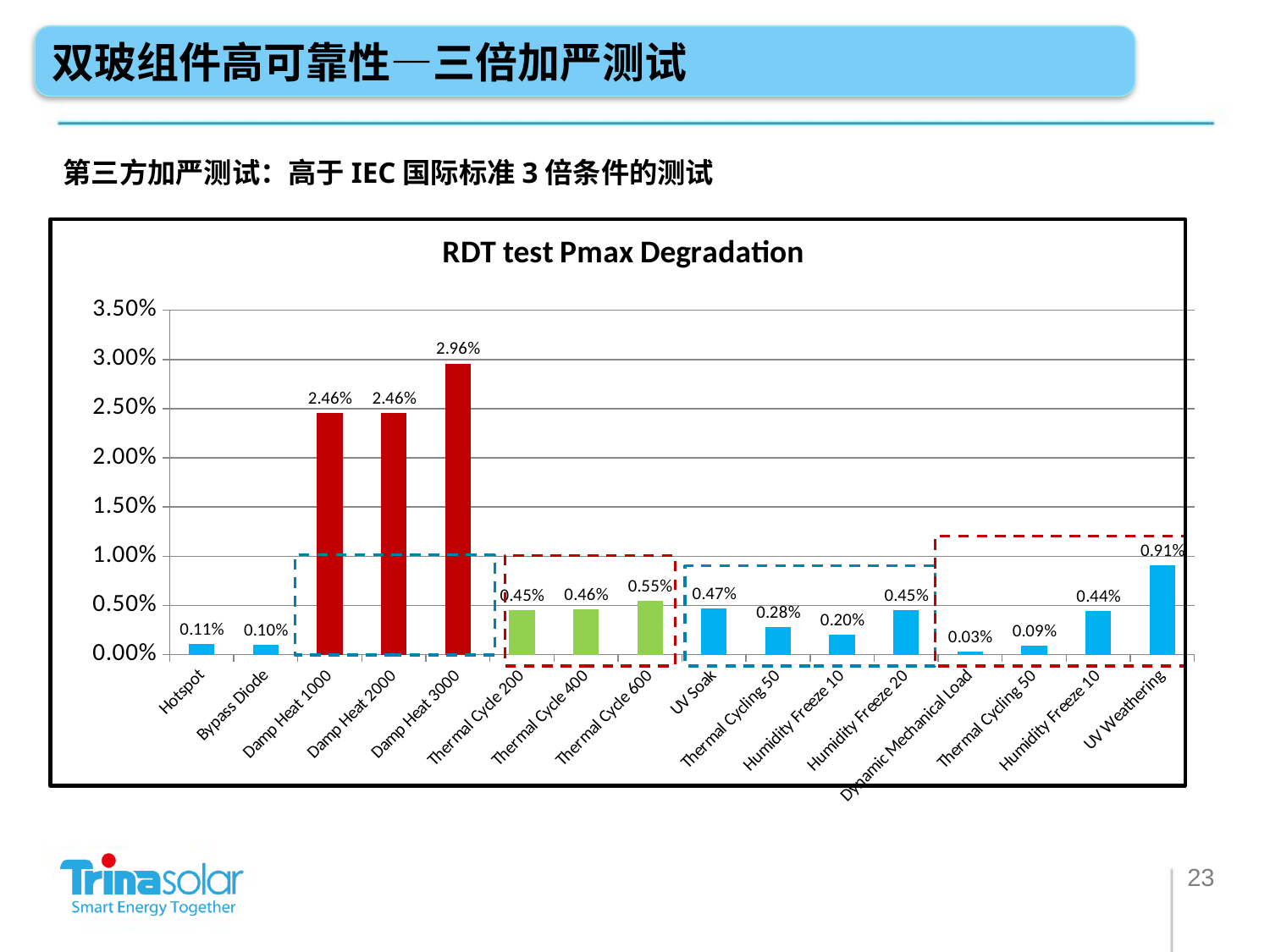
Which category has the highest Pmax degradation? Damp Heat 3000 What type of chart is shown on the slide? bar chart What is the Pmax degradation value for Damp Heat 3000? 2.96% What is the title of the chart? RDT test Pmax Degradation Do the values rise or fall from Thermal Cycle 200 to Thermal Cycle 600? rise What is the Pmax degradation value for Thermal Cycle 600? 0.55% What is the difference between the values for Damp Heat 3000 and Damp Heat 1000? 0.50% How many categories are plotted on the x axis? 16 What is the Pmax degradation value for UV Weathering? 0.91% Which has a larger Pmax degradation, UV Weathering or UV Soak? UV Weathering Is the value for Damp Heat 3000 greater or less than 2.50%? greater Which category has the lowest Pmax degradation? Dynamic Mechanical Load